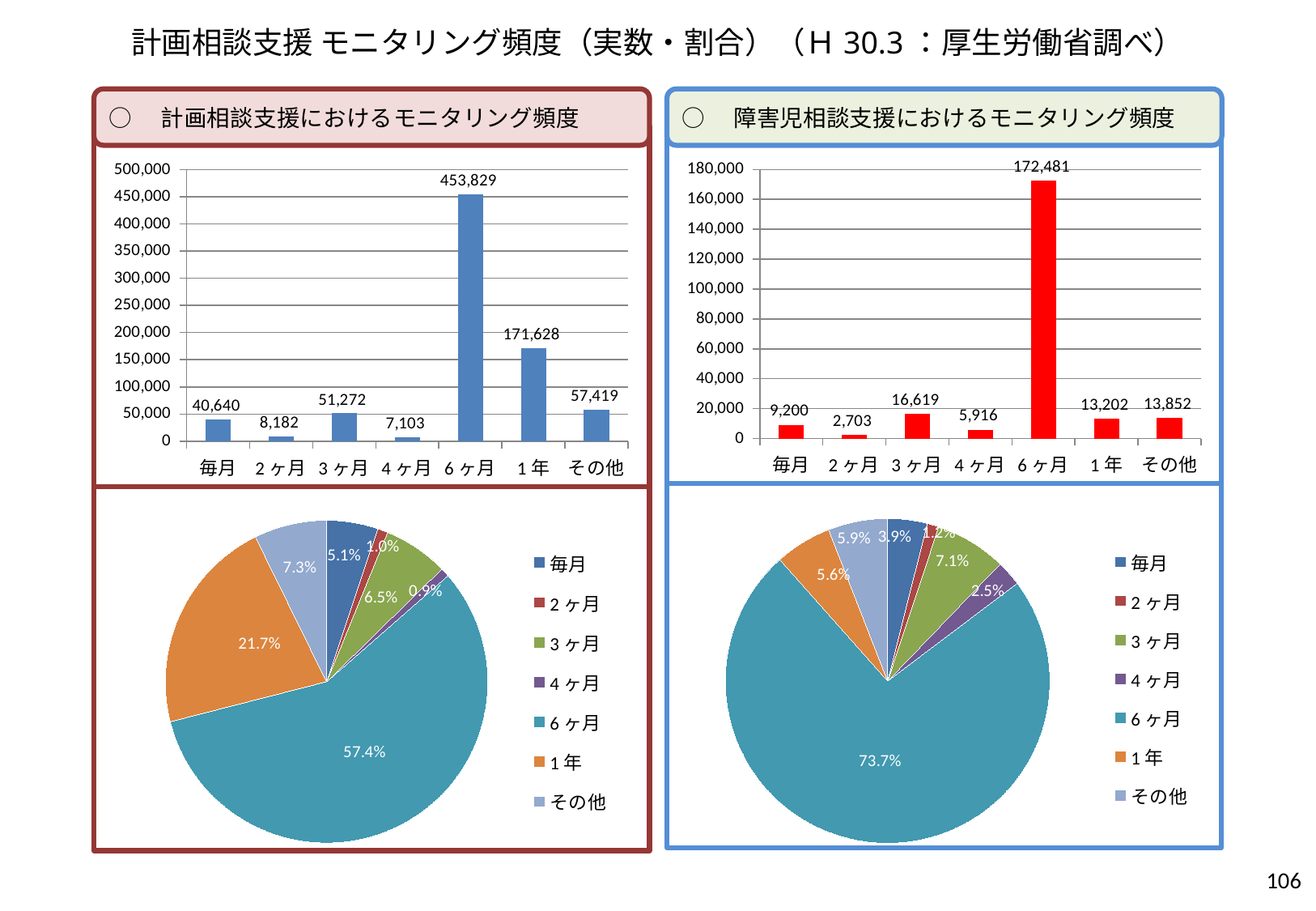
In the bottom-right pie chart (障害児相談支援), what share does 6ヶ月 have? 73.7% What kind of chart is the top-right chart (障害児相談支援におけるモニタリング頻度)? bar chart In the top-left bar chart (計画相談支援におけるモニタリング頻度), what is the value for 6ヶ月? 453,829 In the bottom-left pie chart (計画相談支援), which slice is the smallest? 4ヶ月 In the bottom-left pie chart (計画相談支援), what share does 1年 have? 21.7% How many entries does the legend of the bottom-right pie chart (障害児相談支援) list? 7 In the top-right bar chart (障害児相談支援におけるモニタリング頻度), which category has the highest value? 6ヶ月 In the top-right bar chart (障害児相談支援におけるモニタリング頻度), what is the value for 3ヶ月? 16,619 In the top-right bar chart (障害児相談支援におけるモニタリング頻度), which is larger, the value for 1年 or the value for その他? その他 In the top-left bar chart (計画相談支援におけるモニタリング頻度), how many categories are shown on the x axis? 7 In the top-left bar chart (計画相談支援におけるモニタリング頻度), which category has the lowest value? 4ヶ月 In the top-left bar chart (計画相談支援におけるモニタリング頻度), what is the difference between the values for 1年 and その他? 114,209